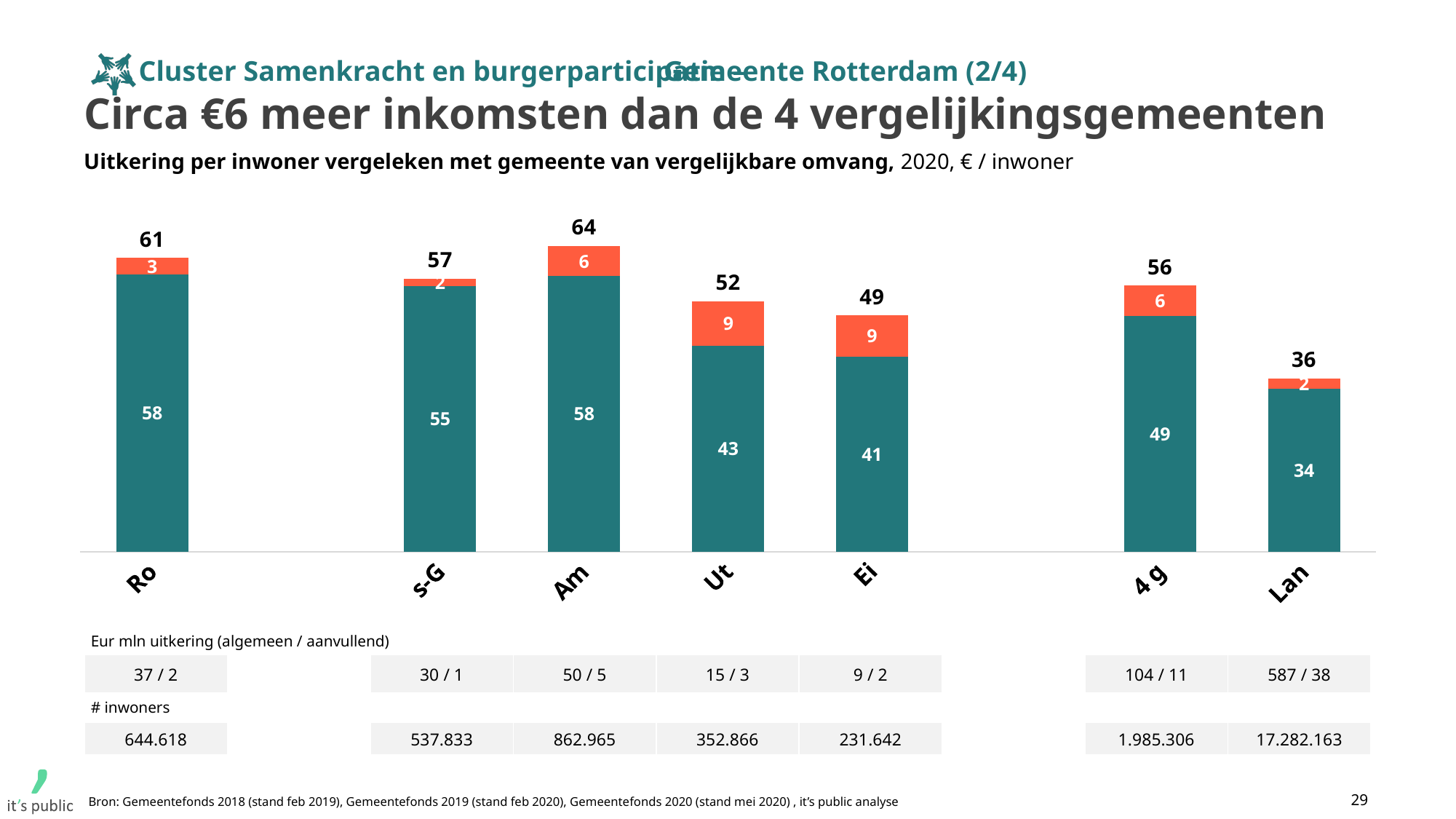
What unit does the chart subtitle state the values are in? € / inwoner What is the value of the orange (upper) segment of the bar for Ei? 9 Which category has the lowest total value? Lan What kind of chart is shown on the slide? Stacked bar chart How many categories (bars) are shown in the chart? 7 What is the total of the stacked bar for Lan? 36 What is the value of the teal (lower) segment of the bar for Ut? 43 What is the value of the teal (lower) segment of the bar for 4 g? 49 Which category has the highest total value? Am What is the difference between the total for Ro and the total for 4 g? 5 What is the total value shown above the bar for Am? 64 Which has a larger total value, s-G or Ut? s-G